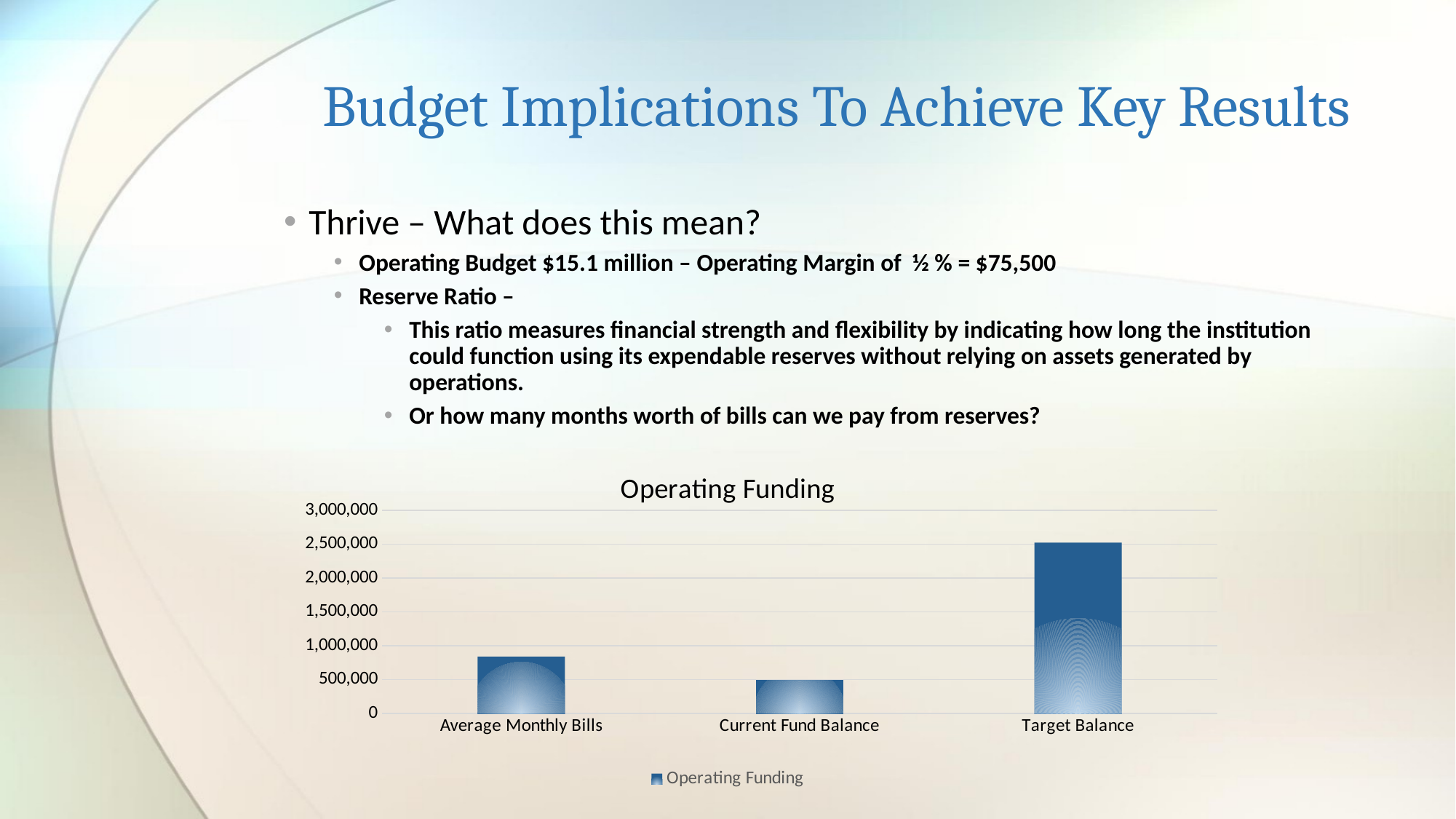
In the Operating Funding chart, which is larger: Target Balance or Average Monthly Bills? Target Balance Is the value for Average Monthly Bills greater or less than 1,000,000? less What is the title of the chart on the slide? Operating Funding Which category has the lowest value in the Operating Funding chart? Current Fund Balance Is the value for Current Fund Balance greater or less than 1,000,000? less How many series does the legend of the Operating Funding chart list? 1 In the Operating Funding chart, which is larger: Average Monthly Bills or Current Fund Balance? Average Monthly Bills Is the value for Average Monthly Bills greater or less than 500,000? greater What kind of chart is the Operating Funding chart? bar chart Which category has the highest value in the Operating Funding chart? Target Balance How many categories are shown on the x axis of the Operating Funding chart? 3